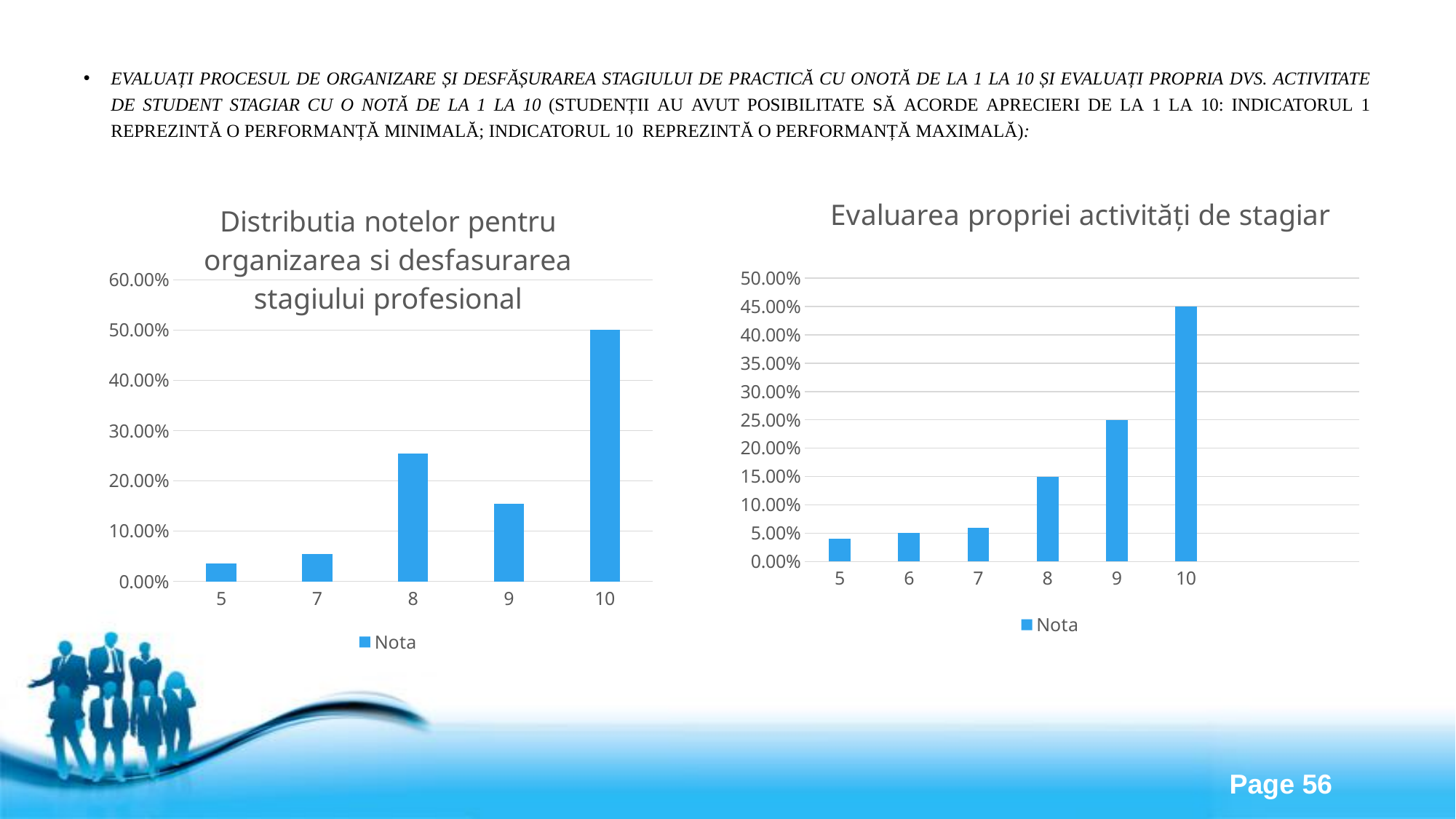
In the chart on the left, which grade has the lowest value? 5 In the chart on the left, is the value for grade 9 greater or less than 20.00%? less In the chart on the left, is the value for grade 8 greater or less than 20.00%? greater In the chart on the right, is the value for grade 7 greater or less than 10.00%? less In the chart titled "Evaluarea propriei activități de stagiar", what is the value for grade 8? 15.00% In the chart titled "Evaluarea propriei activități de stagiar", what is the value for grade 10? 45.00% In the chart titled "Evaluarea propriei activități de stagiar", what is the value for grade 9? 25.00% In the chart on the left, which grade has the highest value? 10 How many grade categories are shown on the x axis of the chart on the right? 6 What type of chart is the chart on the left? bar chart In the chart on the left, which has a larger value, grade 8 or grade 9? 8 In the chart titled "Evaluarea propriei activități de stagiar", which grade has the lowest value? 5